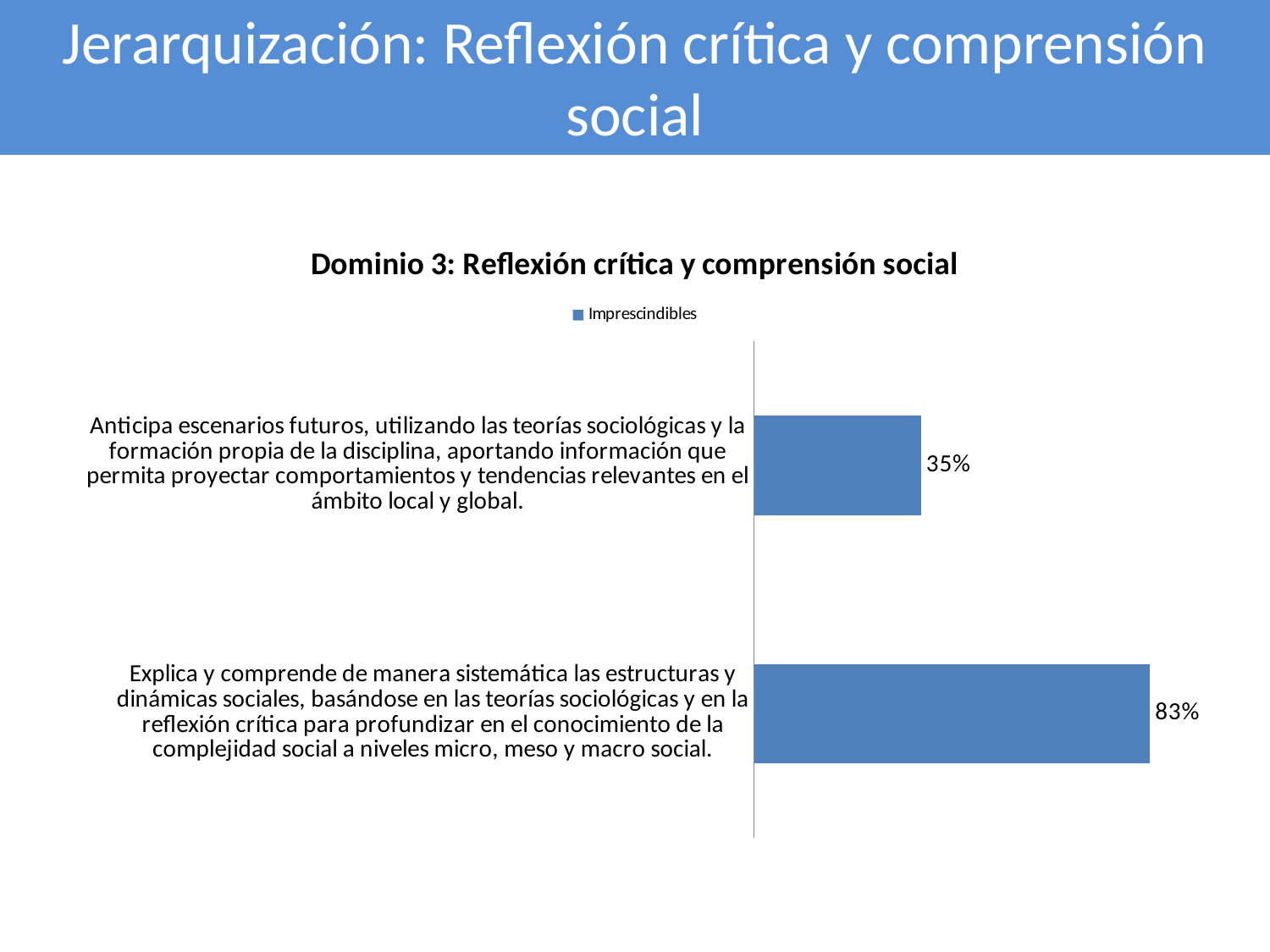
Which is larger: the value for 'Anticipa escenarios futuros...' or the value for 'Explica y comprende...'? Explica y comprende... What is the value for the category 'Anticipa escenarios futuros, utilizando las teorías sociológicas y la formación propia de la disciplina...'? 35% What is the name of the series listed in the legend? Imprescindibles How many series does the legend list? 1 What is the difference between the value for 'Explica y comprende...' and the value for 'Anticipa escenarios futuros...'? 48% What is the title of the chart? Dominio 3: Reflexión crítica y comprensión social How many categories are shown in the chart? 2 What is the value for the category 'Explica y comprende de manera sistemática las estructuras y dinámicas sociales...'? 83% What kind of chart is shown on the slide? Bar chart